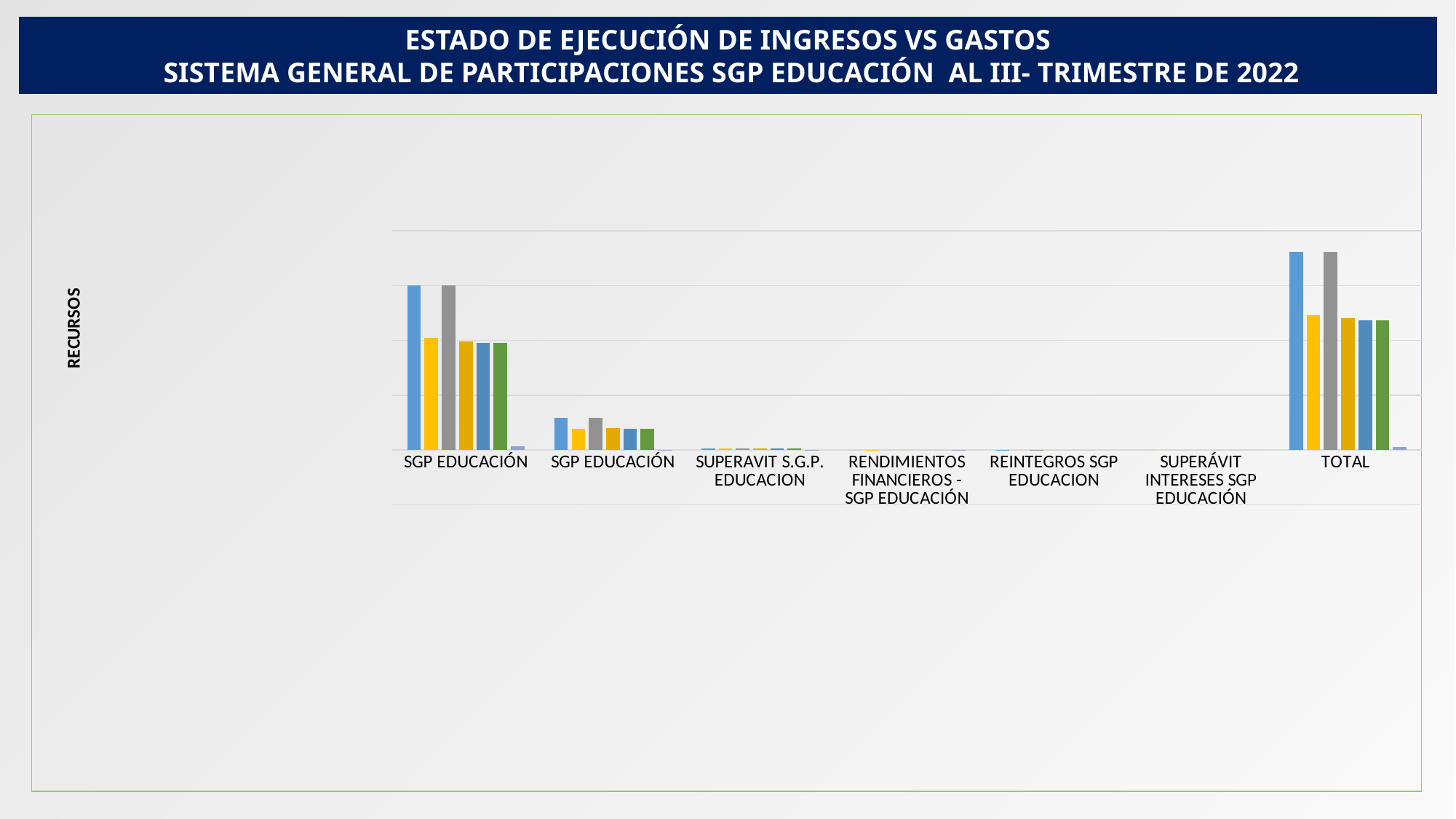
What is the label on the vertical axis of the chart? RECURSOS What is the last category shown on the x axis of the chart? TOTAL Which category has taller bars: TOTAL or SUPERAVIT S.G.P. EDUCACION? TOTAL What kind of chart is shown on the slide? Bar chart Which category has taller bars: the first SGP EDUCACIÓN category or the second SGP EDUCACIÓN category? The first SGP EDUCACIÓN Which category has the tallest bars in the chart? TOTAL How many categories are shown along the x axis of the chart? 7 Which category has taller bars: REINTEGROS SGP EDUCACION or TOTAL? TOTAL